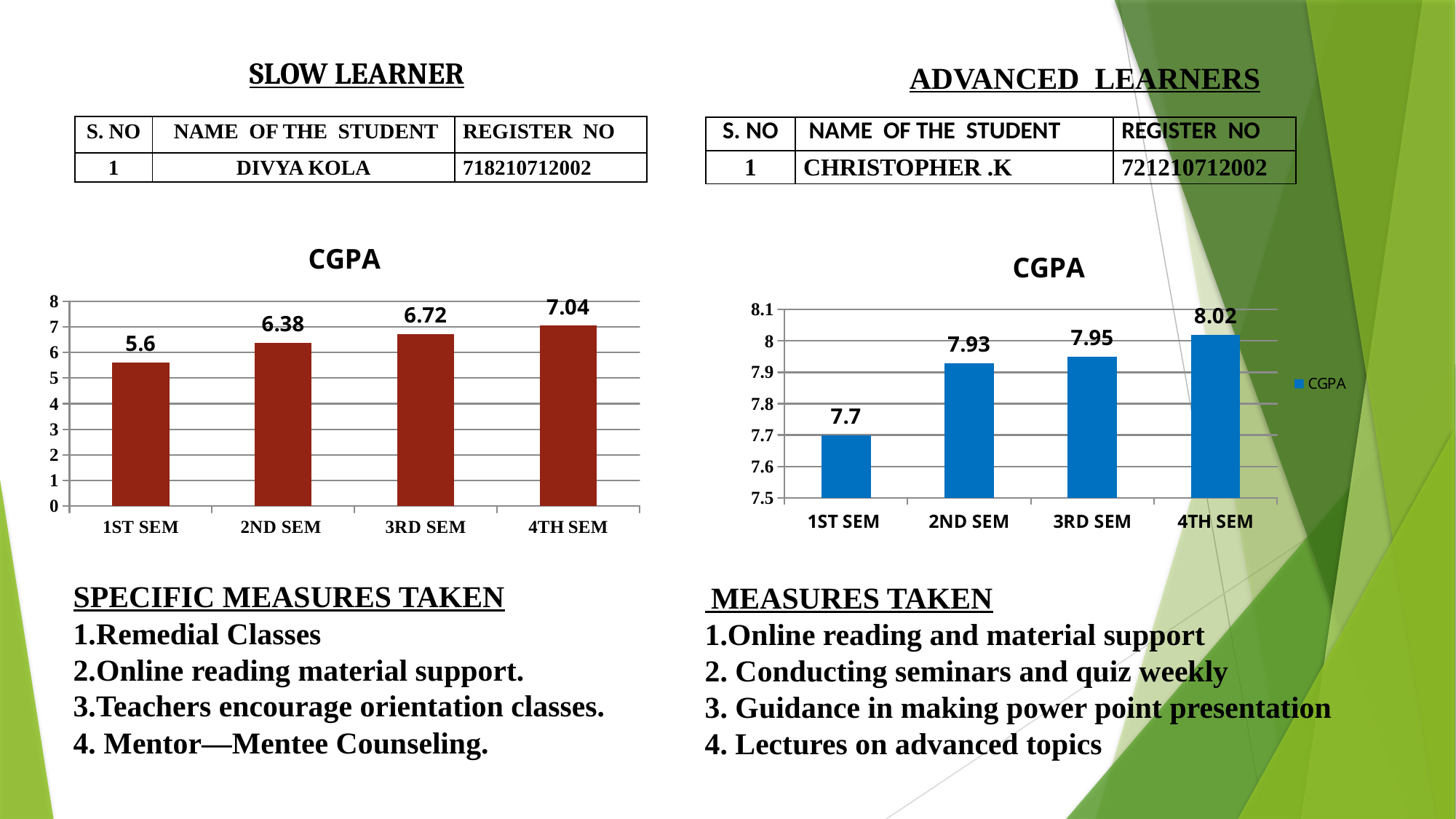
In the right CGPA chart (advanced learners), which semester has the lowest value? 1ST SEM In the right CGPA chart (advanced learners), what is the value for 2ND SEM? 7.93 What kind of chart is the left CGPA chart (slow learner)? Bar chart In the right CGPA chart (advanced learners), what is the value for 4TH SEM? 8.02 In the left CGPA chart (slow learner), which semester has the highest value? 4TH SEM In the right CGPA chart (advanced learners), what is the difference between the 2ND SEM and 1ST SEM values? 0.23 In the left CGPA chart (slow learner), what is the value for 3RD SEM? 6.72 How many semesters are plotted in the right CGPA chart (advanced learners)? 4 In the left CGPA chart (slow learner), which is larger, the value for 2ND SEM or 3RD SEM? 3RD SEM In the right CGPA chart (advanced learners), do the values rise or fall from 1ST SEM to 4TH SEM? Rise In the left CGPA chart (slow learner), what is the difference between the 4TH SEM and 1ST SEM values? 1.44 In the left CGPA chart (slow learner), what is the value for 1ST SEM? 5.6